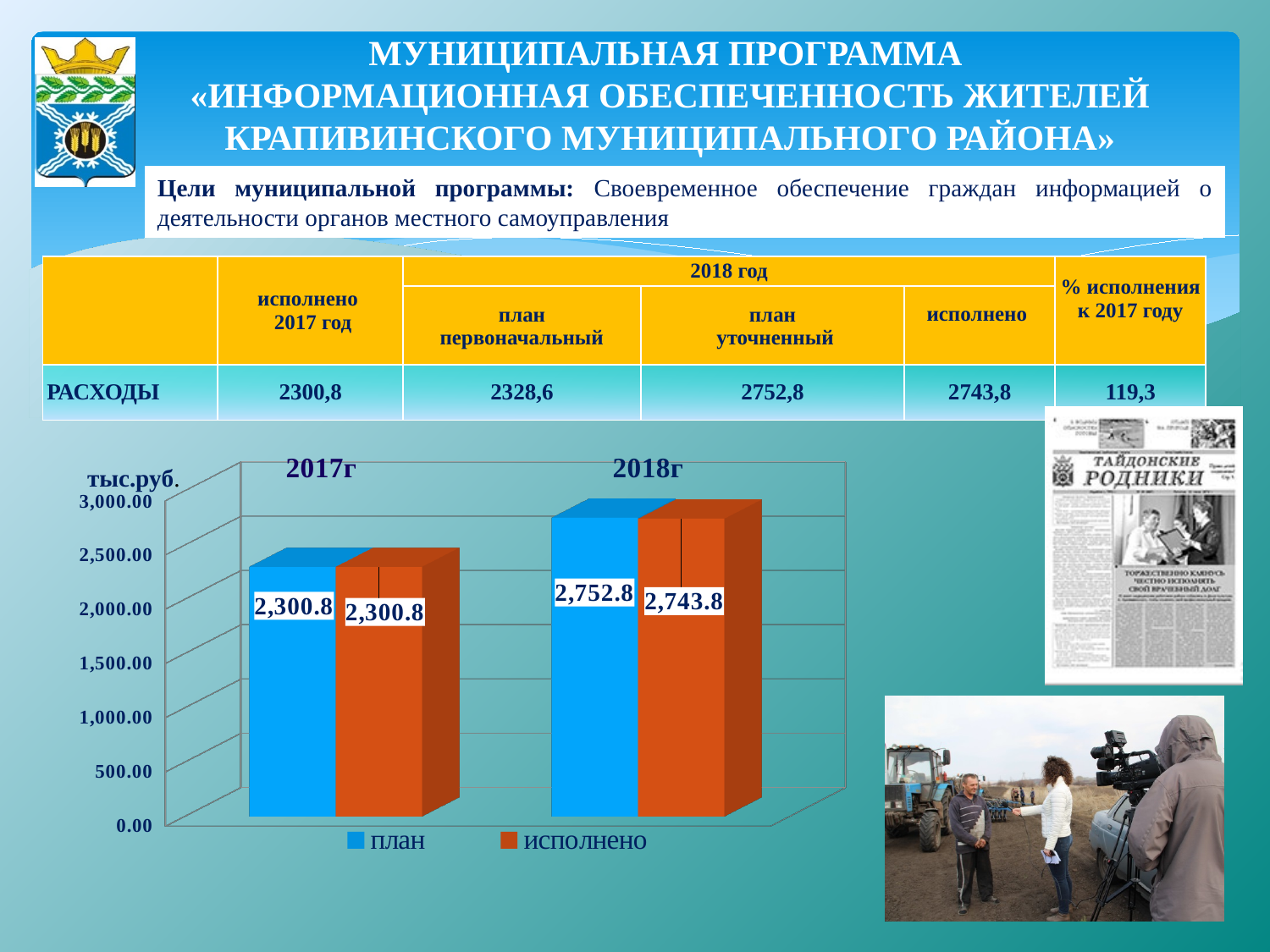
What is the value of исполнено for 2017г? 2,300.8 What unit label is shown above the vertical axis? тыс.руб. What is the value of план for 2017г? 2,300.8 What is the value of план for 2018г? 2,752.8 What is the difference between план for 2018г and план for 2017г? 452.0 What is the value of исполнено for 2018г? 2,743.8 What is the difference between план and исполнено for 2018г? 9.0 How many categories are shown on the x axis? 2 Does the исполнено value rise or fall from 2017г to 2018г? rise What type of chart is shown on the slide? bar chart How many series does the legend list? 2 Which category has the highest план value? 2018г